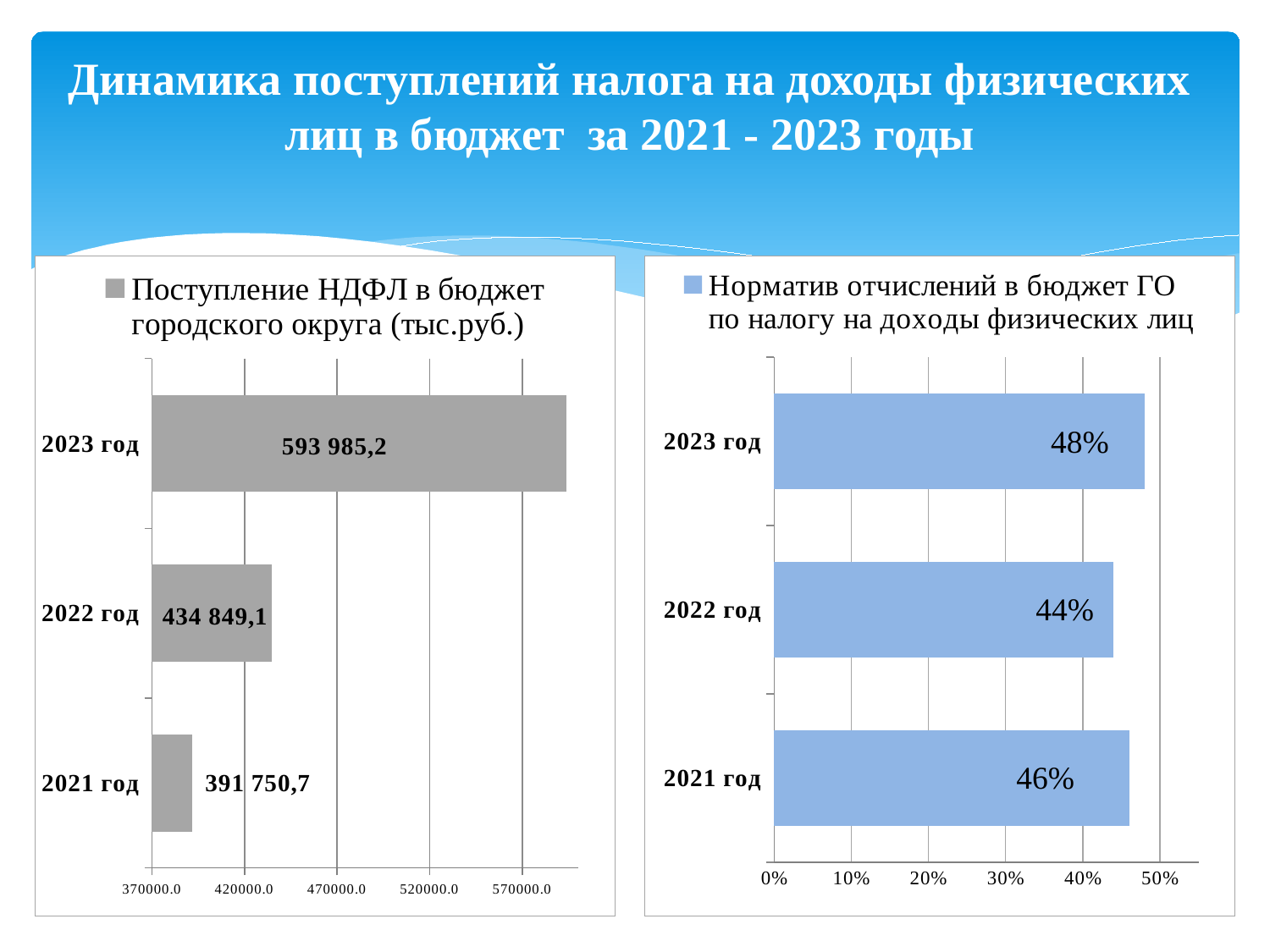
In the left chart (Поступление НДФЛ в бюджет городского округа), what is the difference between the values for 2023 год and 2022 год? 159 136,1 In the right chart (Норматив отчислений в бюджет ГО), what is the difference between the values for 2023 год and 2022 год? 4% In the left chart (Поступление НДФЛ в бюджет городского округа), what is the value for 2021 год? 391 750,7 In the left chart (Поступление НДФЛ в бюджет городского округа), do the values rise or fall from 2021 год to 2023 год? rise In the right chart (Норматив отчислений в бюджет ГО), what is the value for 2022 год? 44% How many years are shown in the left chart (Поступление НДФЛ в бюджет городского округа)? 3 What type of chart is the right chart (Норматив отчислений в бюджет ГО)? bar chart In the right chart (Норматив отчислений в бюджет ГО), which year has the highest value? 2023 год In the left chart (Поступление НДФЛ в бюджет городского округа), what is the value for 2023 год? 593 985,2 In the left chart (Поступление НДФЛ в бюджет городского округа), is the value for 2022 год greater or less than 420000.0? greater In the left chart (Поступление НДФЛ в бюджет городского округа), which year has the lowest value? 2021 год In the right chart (Норматив отчислений в бюджет ГО), which is larger: the value for 2021 год or 2022 год? 2021 год